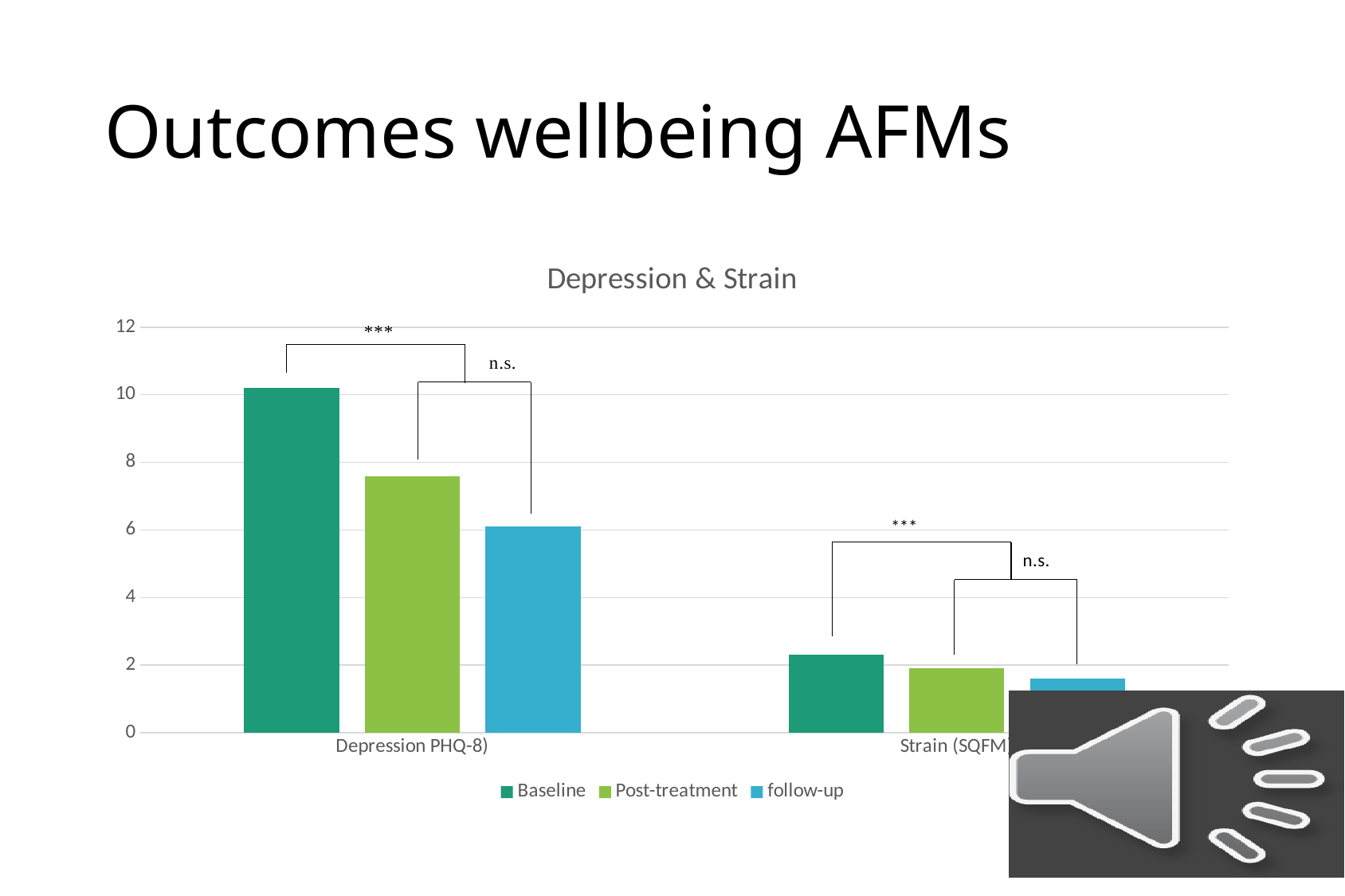
Which series has the highest value for Depression PHQ-8)? Baseline How many categories are shown on the x axis? 2 Which is larger for Depression PHQ-8): the Post-treatment value or the follow-up value? Post-treatment Which legend entry is shown in blue? follow-up Is the Post-treatment value for Depression PHQ-8) greater or less than 8? less What type of chart is shown on the slide? bar chart Is the Baseline value for Depression PHQ-8) greater or less than 8? greater What is the title of the chart? Depression & Strain Is the follow-up value for Strain (SQFM) greater or less than 2? less Which series has the lowest value for Depression PHQ-8)? follow-up How many series does the legend list? 3 Which category has the higher Baseline value: Depression PHQ-8) or Strain (SQFM)? Depression PHQ-8)